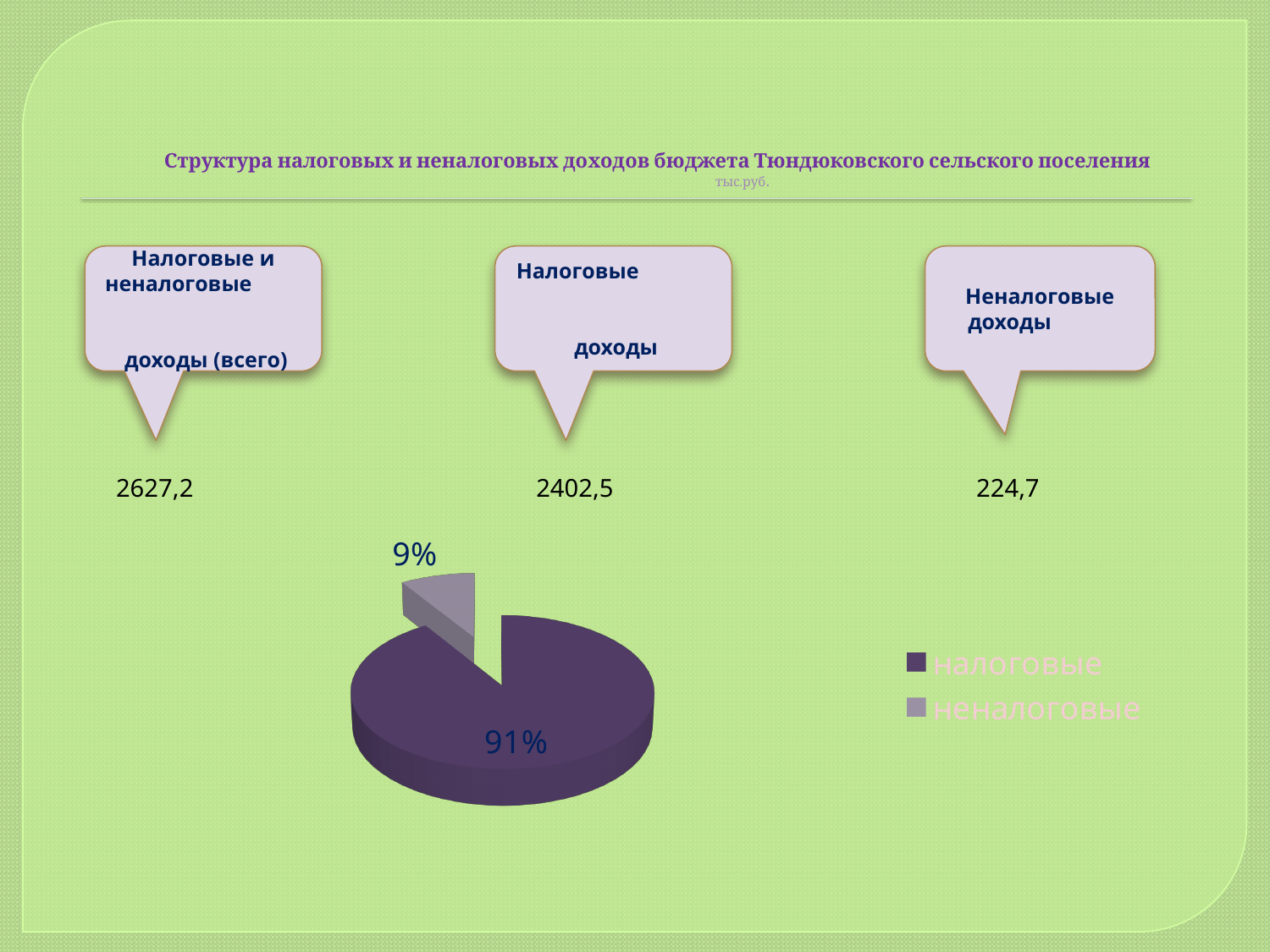
What share of the pie chart does the "неналоговые" slice represent? 9% Which slice of the pie chart is the largest? налоговые Which is larger in the pie chart: the "налоговые" slice or the "неналоговые" slice? налоговые What unit is stated under the slide title above the chart? тыс.руб. Which slice of the pie chart is the smallest? неналоговые Which legend entry of the pie chart is shown in the dark purple colour? налоговые What is the difference in percentage points between the "налоговые" and "неналоговые" slices of the pie chart? 82 How many slices does the pie chart have? 2 What kind of chart is shown on the slide? pie chart What share of the pie chart does the "налоговые" slice represent? 91% How many entries does the pie chart's legend list? 2